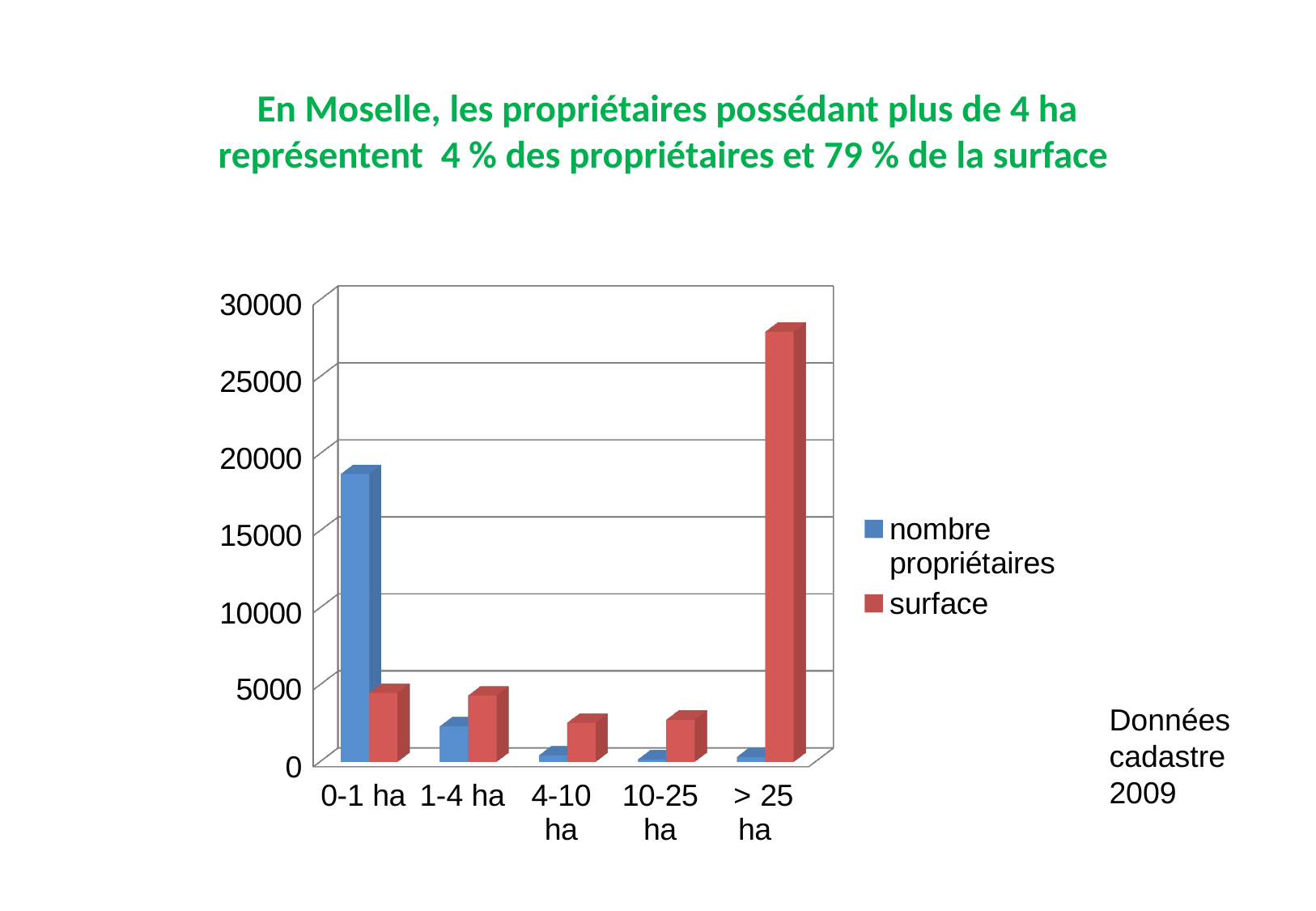
What kind of chart is shown on the slide? bar chart Which category has the highest value for the nombre propriétaires series? 0-1 ha How many categories of property size are shown on the x axis? 5 Do the values of the nombre propriétaires series rise or fall from 0-1 ha to > 25 ha? fall How many series does the legend list? 2 What data source is cited next to the chart? Données cadastre 2009 Which category has the highest value for the surface series? > 25 ha Is the value of nombre propriétaires for 0-1 ha greater or less than 15000? greater Is the value of surface for > 25 ha greater or less than 25000? greater For the 0-1 ha category, which is larger: nombre propriétaires or surface? nombre propriétaires For the > 25 ha category, which is larger: nombre propriétaires or surface? surface